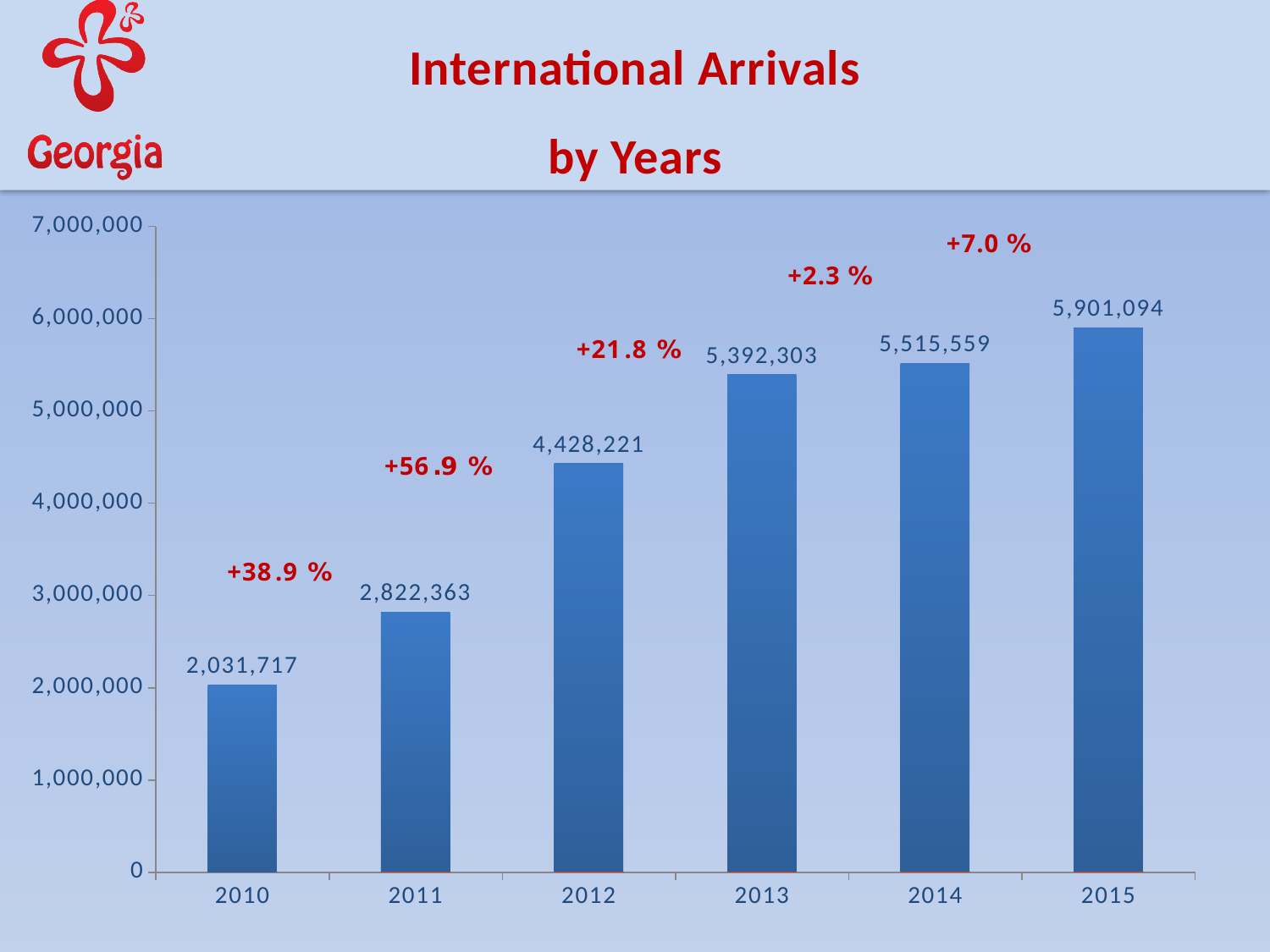
What percentage growth is shown between 2011 and 2012? +56.9 % Is the value for 2014 greater or less than 5,000,000? greater What is the value of international arrivals for 2015? 5,901,094 What is the value of international arrivals for 2013? 5,392,303 Which year has the lowest number of international arrivals? 2010 What is the difference in international arrivals between 2015 and 2014? 385,535 What is the value of international arrivals for 2010? 2,031,717 What is the difference in international arrivals between 2012 and 2011? 1,605,858 What kind of chart is shown on the slide? Bar chart Which year had more international arrivals, 2012 or 2013? 2013 How many years are shown on the chart? 6 Which year has the highest number of international arrivals? 2015